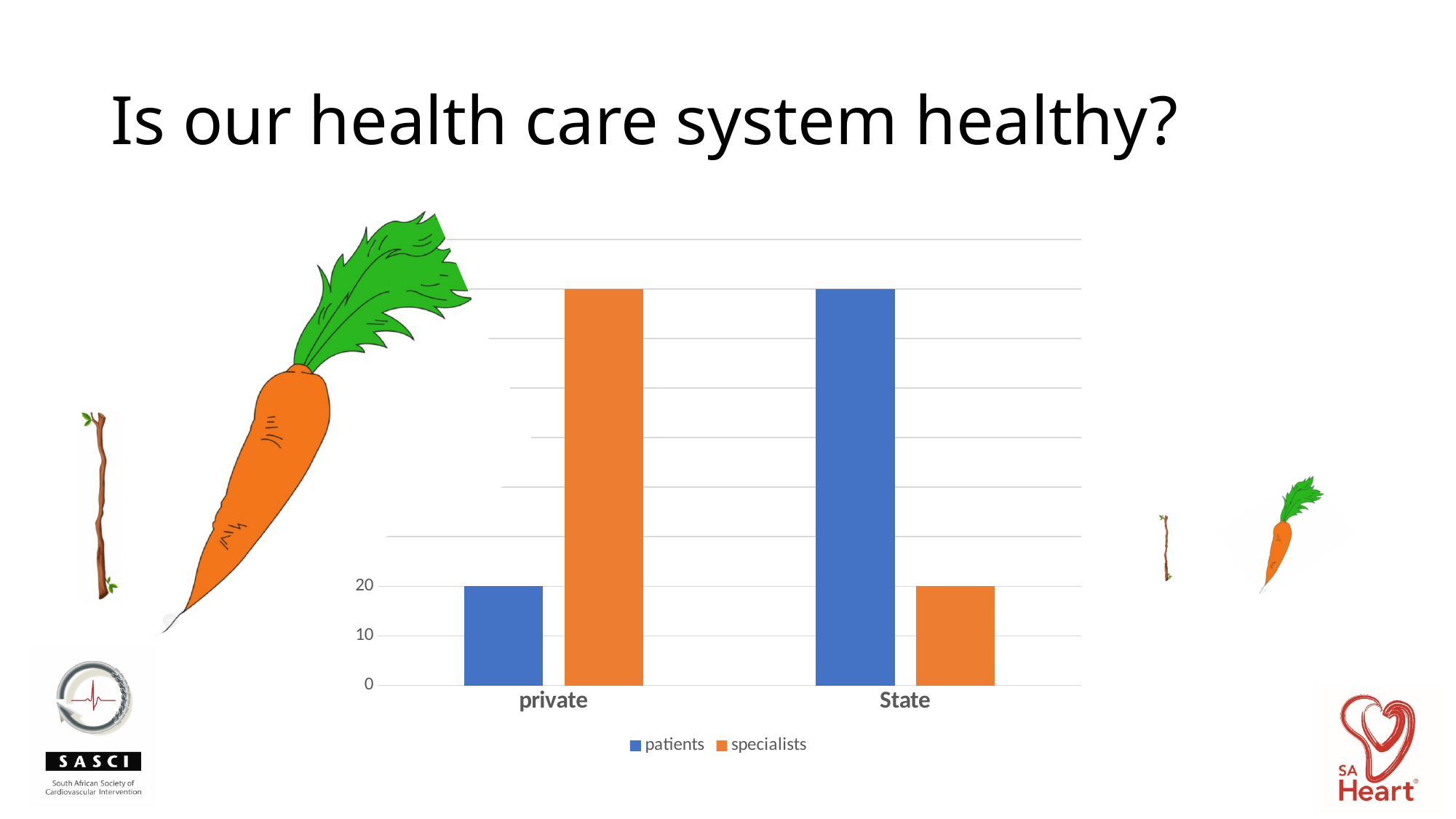
How many categories are shown on the x axis of the chart? 2 Which category has the lower value for specialists, private or State? State What is the value for patients in the private category? 20 Is the value for patients in the State category greater or less than 20? greater In the private category, which series has the larger value, patients or specialists? specialists Which category has the higher value for patients, private or State? State What is the value for specialists in the State category? 20 What are the two entries listed in the chart's legend? patients, specialists Is the value for specialists in the private category greater or less than 20? greater How many series does the chart's legend list? 2 What kind of chart is shown on the slide? bar chart In the State category, which series has the larger value, patients or specialists? patients